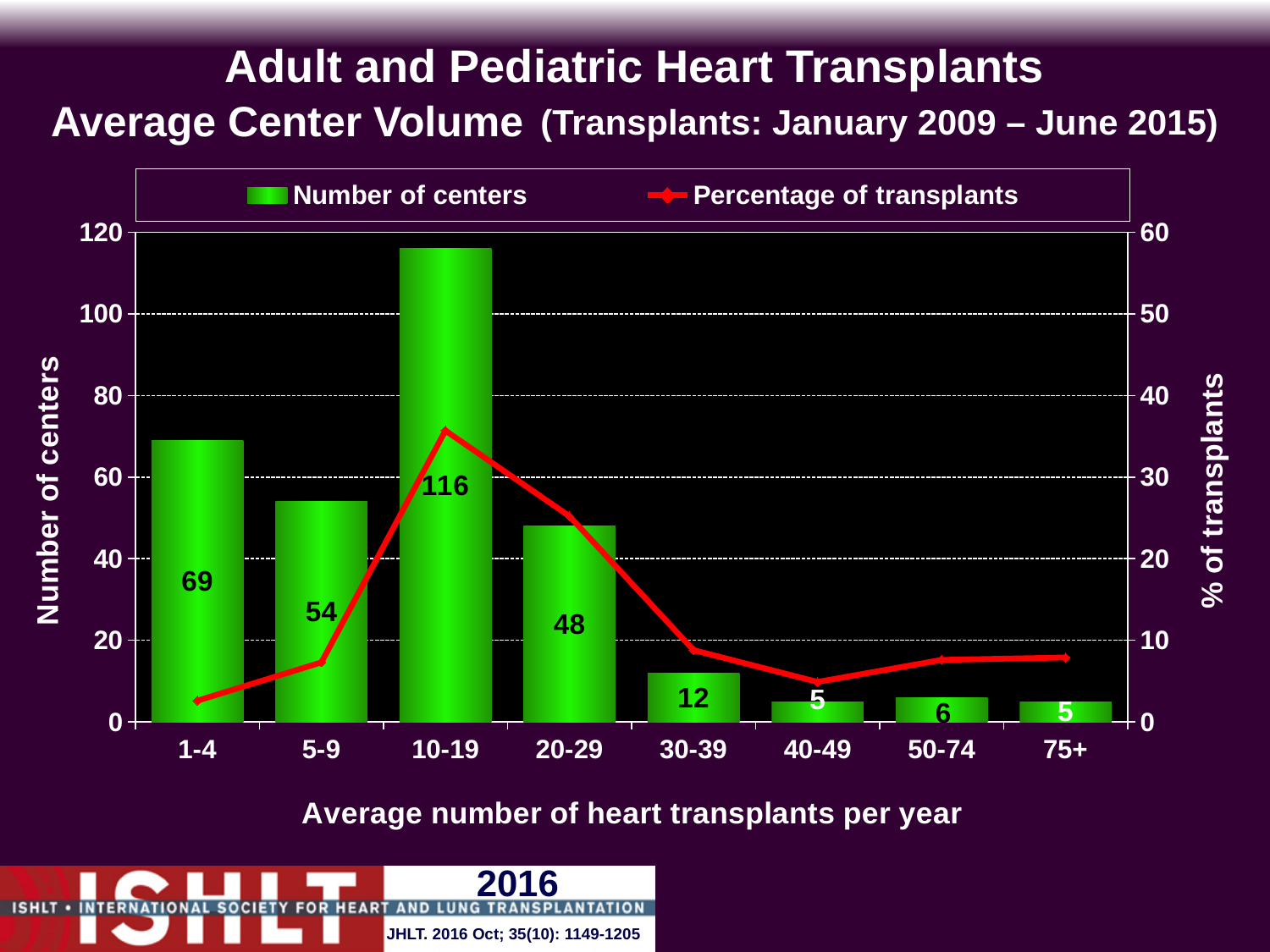
Is the percentage of transplants for the 10-19 category greater or less than 30? greater What kind of chart is used to show the number of centers? bar chart How many series does the legend list? 2 What is the difference in number of centers between the 1-4 and 5-9 categories? 15 Is the percentage of transplants for the 1-4 category greater or less than 10? less How many centers are in the 10-19 average transplants per year category? 116 Which category has the highest number of centers? 10-19 Which has more centers, the 20-29 category or the 5-9 category? 5-9 How many average-volume categories are shown on the x axis? 8 What is the number of centers for the 1-4 category? 69 What is the label of the right-hand vertical axis? % of transplants What is the number of centers for the 30-39 category? 12